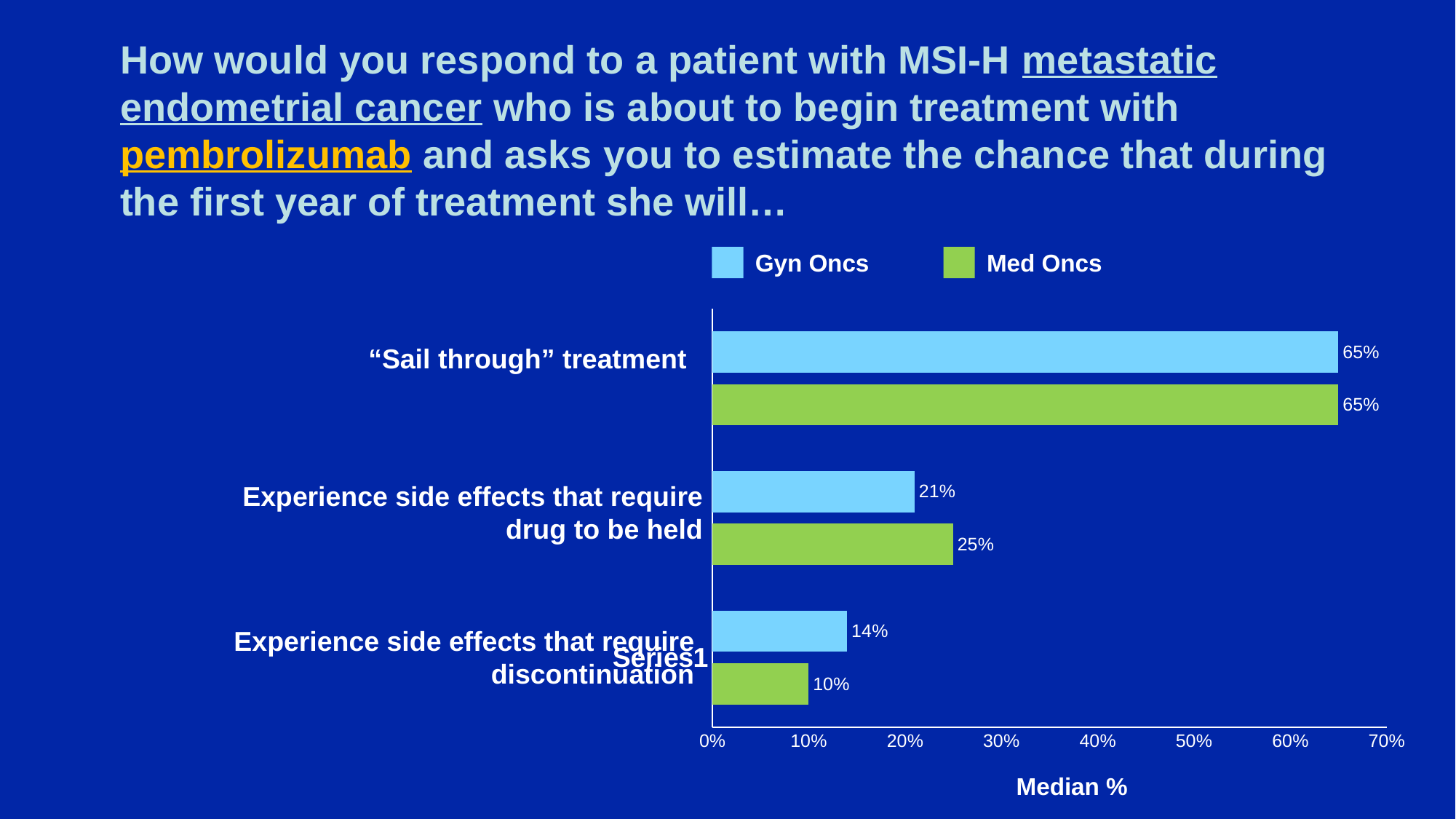
What is the Gyn Oncs value for "Sail through" treatment? 65% What is the label on the horizontal axis of the chart? Median % What is the Med Oncs value for "Experience side effects that require discontinuation"? 10% How many series does the legend list? 2 What is the Gyn Oncs value for "Experience side effects that require discontinuation"? 14% What is the Med Oncs value for "Experience side effects that require drug to be held"? 25% For "Experience side effects that require discontinuation", which is larger: the Gyn Oncs value or the Med Oncs value? Gyn Oncs What kind of chart is shown on the slide? Bar chart What is the difference between the Med Oncs and Gyn Oncs values for "Experience side effects that require drug to be held"? 4% Which category has the lowest Gyn Oncs value? Experience side effects that require discontinuation Which category has the highest Med Oncs value? "Sail through" treatment How many categories are shown on the chart? 3